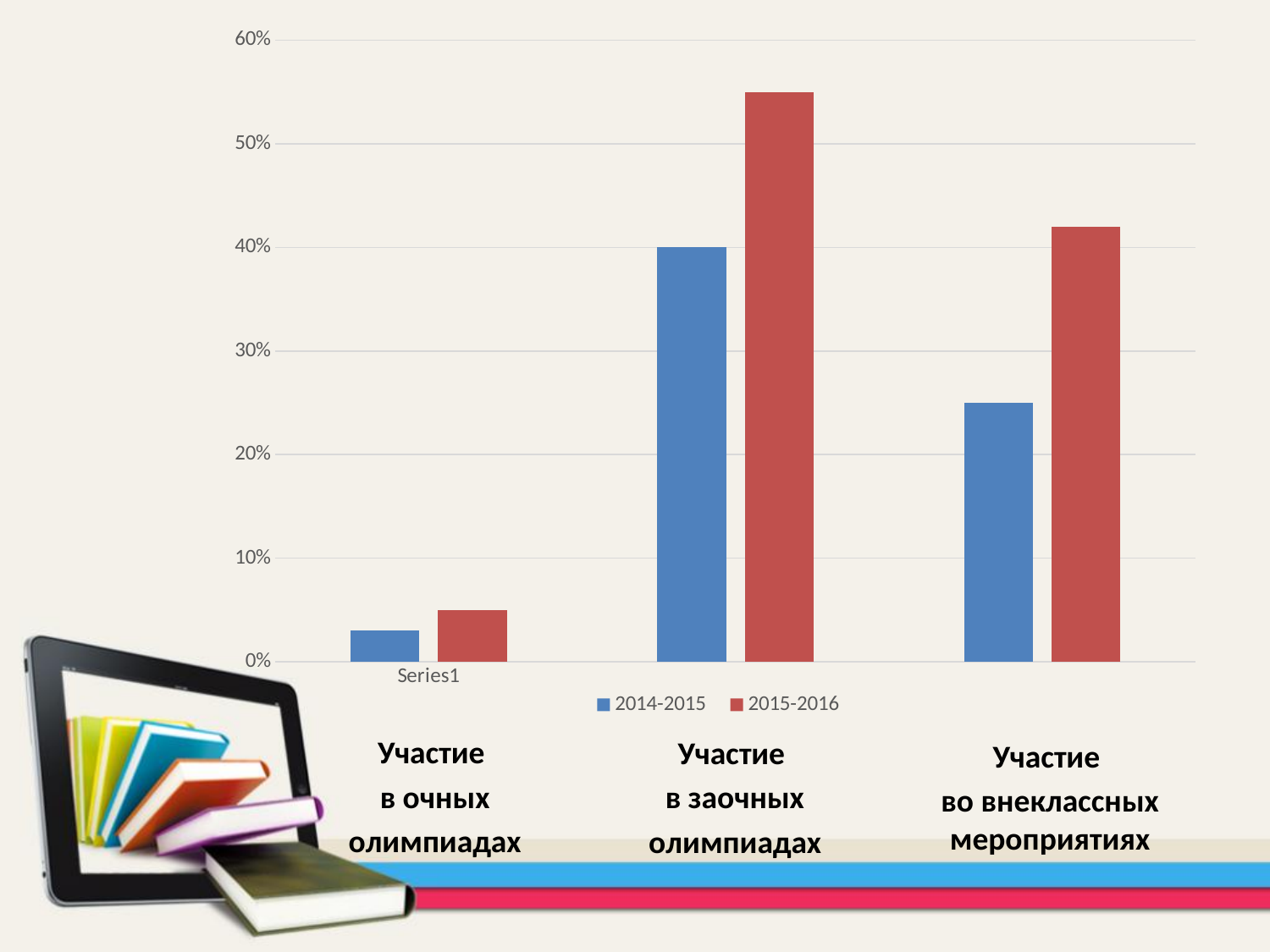
Which colour represents the 2015-2016 series? red How many categories are plotted on the chart? 3 What kind of chart is shown on the slide? bar chart What are the two series named in the legend? 2014-2015 and 2015-2016 Is the 2015-2016 value for Участие во внеклассных мероприятиях greater or less than 40%? greater Is the 2014-2015 value for Участие во внеклассных мероприятиях greater or less than 30%? less Is the 2015-2016 value for Участие в заочных олимпиадах greater or less than 50%? greater Which category has the lowest value for the 2014-2015 series? Участие в очных олимпиадах Which category has the highest value for the 2015-2016 series? Участие в заочных олимпиадах For Участие в заочных олимпиадах, which series has the larger value, 2014-2015 or 2015-2016? 2015-2016 How many series does the legend list? 2